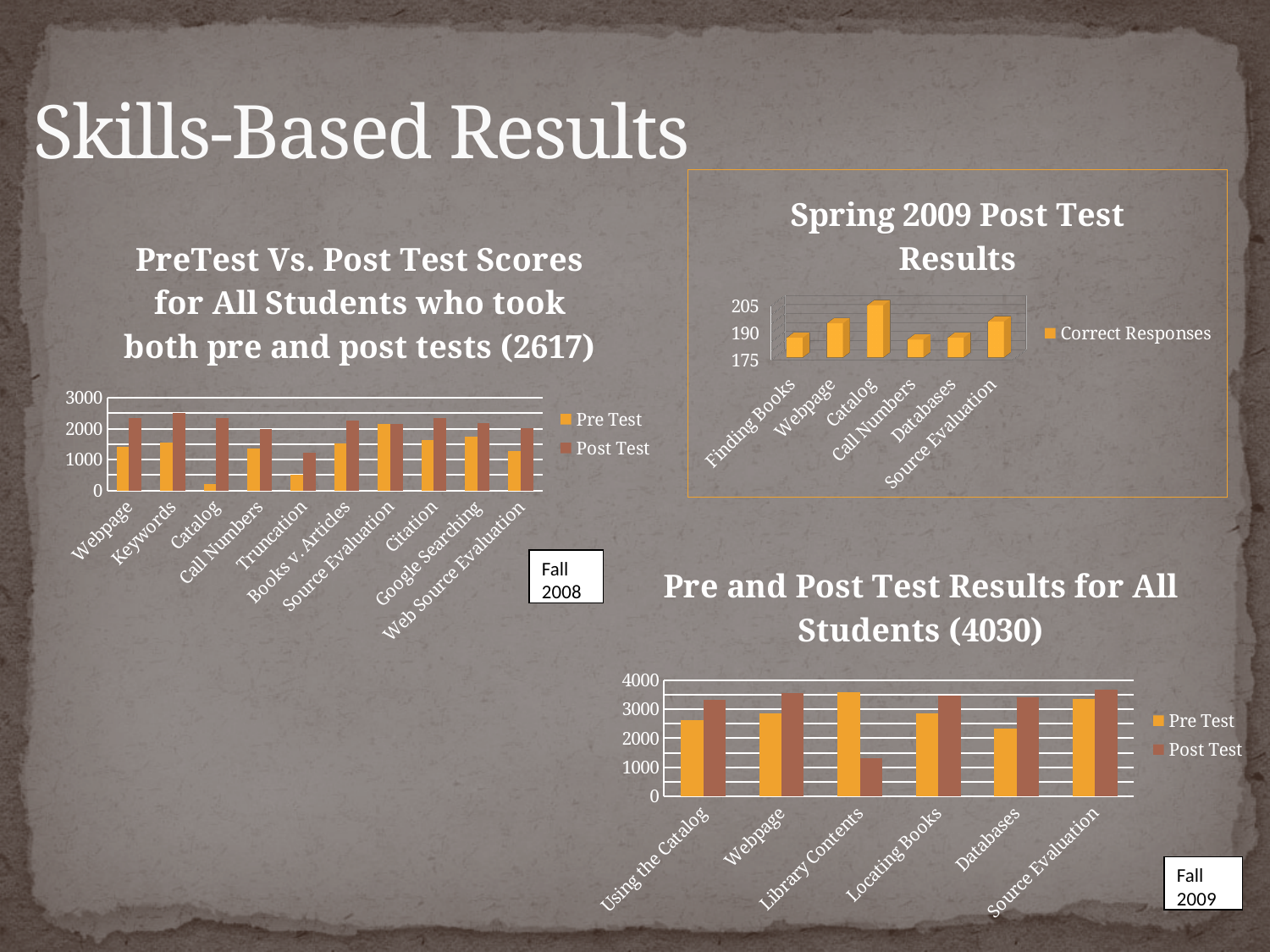
In the 'PreTest Vs. Post Test Scores for All Students who took both pre and post tests (2617)' chart, which category has the lowest Pre Test value? Catalog In the 'PreTest Vs. Post Test Scores for All Students who took both pre and post tests (2617)' chart, which category has the lowest Post Test value? Truncation In the 'Pre and Post Test Results for All Students (4030)' chart, is the Pre Test or Post Test value larger for Library Contents? Pre Test What is the name of the single series in the legend of the 'Spring 2009 Post Test Results' chart? Correct Responses In the 'Pre and Post Test Results for All Students (4030)' chart, is the Pre Test value for Databases greater or less than 3000? less In the 'PreTest Vs. Post Test Scores for All Students who took both pre and post tests (2617)' chart, is the Post Test value for Keywords greater or less than 2000? greater How many categories are shown in the 'Spring 2009 Post Test Results' chart? 6 In the 'Spring 2009 Post Test Results' chart, which category has the highest number of correct responses? Catalog How many categories are shown in the 'PreTest Vs. Post Test Scores for All Students who took both pre and post tests (2617)' chart? 10 What type of chart is the 'Spring 2009 Post Test Results' chart? bar chart How many series does the legend list in the 'Pre and Post Test Results for All Students (4030)' chart? 2 In the 'Pre and Post Test Results for All Students (4030)' chart, which category has the lowest Post Test value? Library Contents